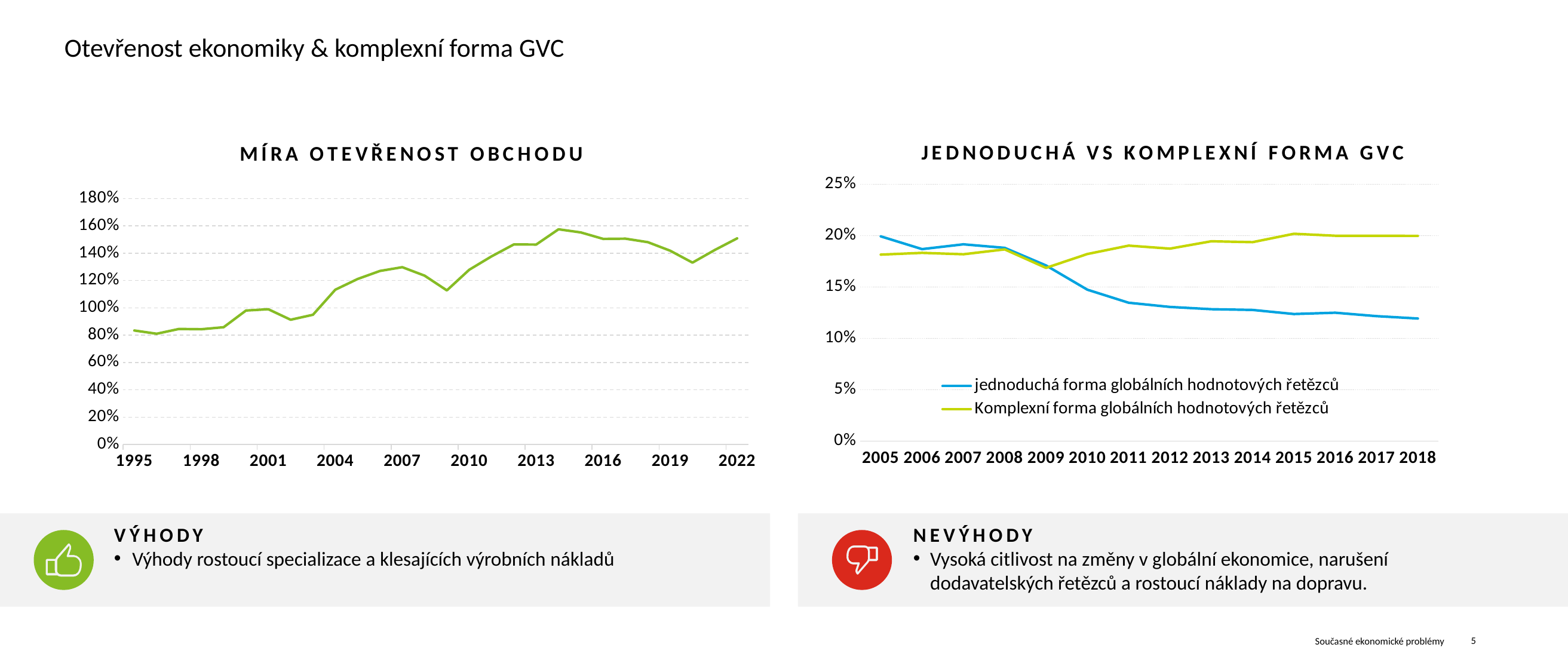
What kind of chart is the chart titled MÍRA OTEVŘENOST OBCHODU? line chart How many series does the legend list in the chart titled JEDNODUCHÁ VS KOMPLEXNÍ FORMA GVC? 2 In the chart titled MÍRA OTEVŘENOST OBCHODU, which is larger, the value for 1995 or the value for 2022? 2022 In the chart titled MÍRA OTEVŘENOST OBCHODU, is the value for 2022 greater or less than 140%? greater How many years are labelled on the x axis of the chart titled JEDNODUCHÁ VS KOMPLEXNÍ FORMA GVC? 14 In the chart titled JEDNODUCHÁ VS KOMPLEXNÍ FORMA GVC, does the series 'jednoduchá forma globálních hodnotových řetězců' rise or fall from 2005 to 2018? fall In the chart titled JEDNODUCHÁ VS KOMPLEXNÍ FORMA GVC, what colour is the line for 'jednoduchá forma globálních hodnotových řetězců'? blue In the chart titled JEDNODUCHÁ VS KOMPLEXNÍ FORMA GVC, is the 2018 value for 'jednoduchá forma globálních hodnotových řetězců' greater or less than 15%? less In the chart titled JEDNODUCHÁ VS KOMPLEXNÍ FORMA GVC, which series has the higher value in 2005? jednoduchá forma globálních hodnotových řetězců In the chart titled MÍRA OTEVŘENOST OBCHODU, is the value for 1995 greater or less than 100%? less In the chart titled MÍRA OTEVŘENOST OBCHODU, do the values overall rise or fall from 1995 to 2022? rise In the chart titled JEDNODUCHÁ VS KOMPLEXNÍ FORMA GVC, which series has the higher value in 2018? Komplexní forma globálních hodnotových řetězců